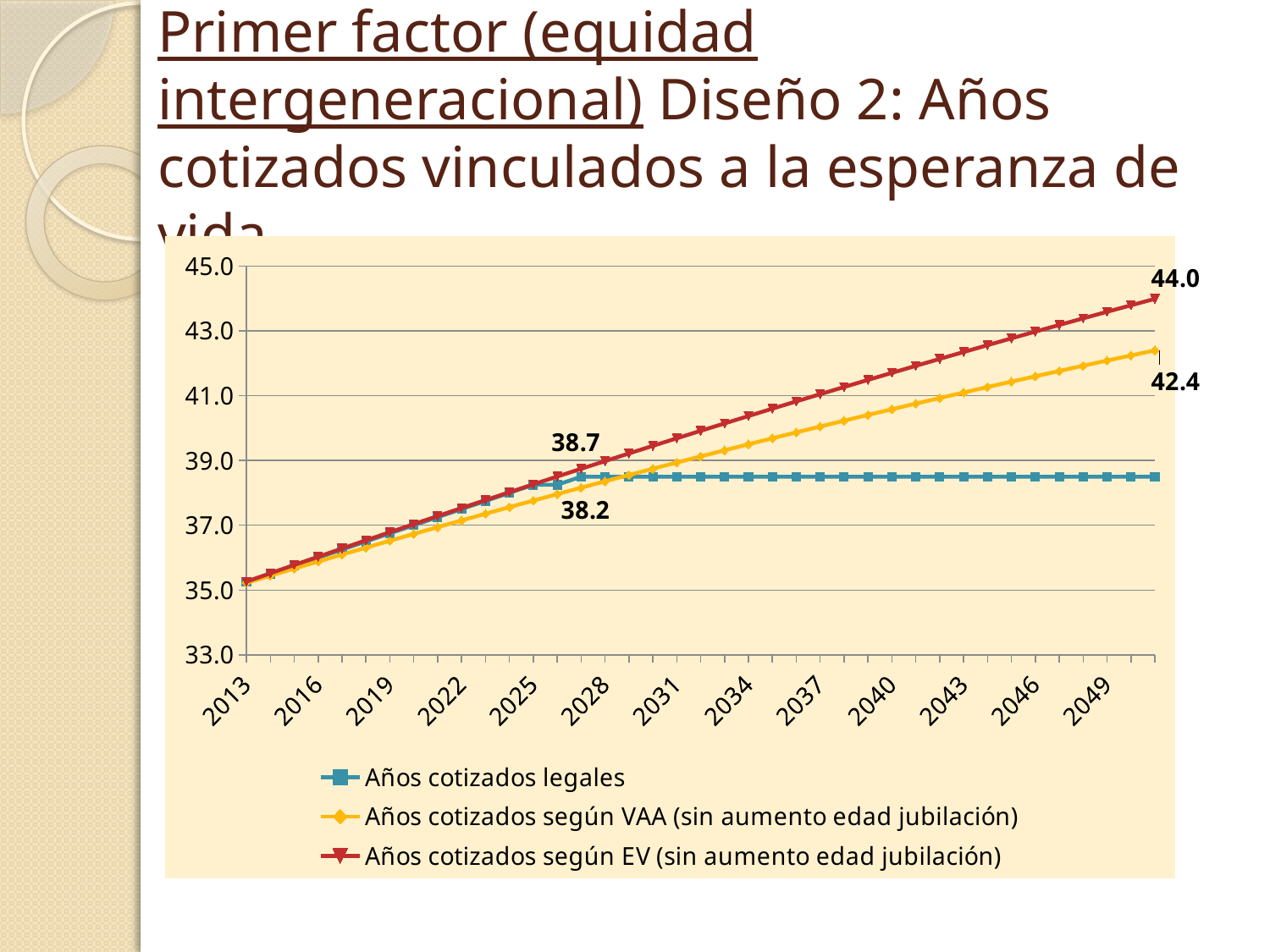
How many series does the legend list? 3 Is the value of the EV series in 2049 greater or less than 43.0? greater What is the final labelled value of the series 'Años cotizados según EV (sin aumento edad jubilación)'? 44.0 Which series reaches the highest value at the right end of the chart? Años cotizados según EV (sin aumento edad jubilación) What kind of chart is shown on the slide? line chart Which series has the lowest value at the right end of the chart? Años cotizados legales Does the series 'Años cotizados según EV (sin aumento edad jubilación)' rise or fall from 2013 to the end of the chart? rise Is the value of 'Años cotizados legales' in 2049 greater or less than 39.0? less What is the first year shown on the x axis? 2013 At the right end of the chart, which is larger: the EV series or the VAA series? Años cotizados según EV (sin aumento edad jubilación) What is the final labelled value of the series 'Años cotizados según VAA (sin aumento edad jubilación)'? 42.4 What is the difference between the final labelled values of the EV series (44.0) and the VAA series (42.4)? 1.6